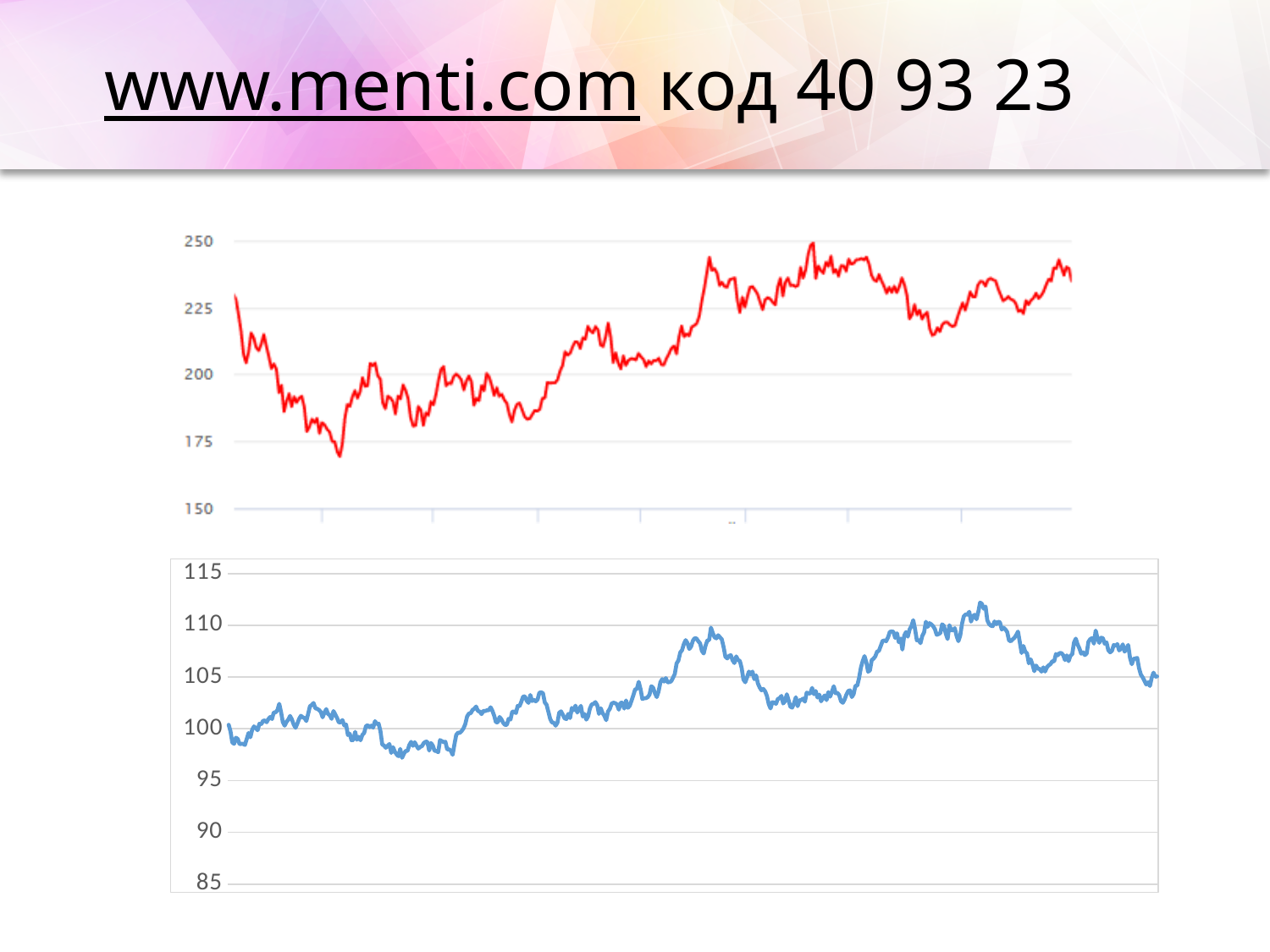
In the top chart, is the highest point of the red line greater or less than 225? greater What kind of chart is the bottom chart on the slide? line chart What kind of chart is the top chart on the slide? line chart In the bottom chart, is the lowest point of the blue line greater or less than 100? less In the top chart, is the value at the right end of the red line greater or less than 225? greater In the bottom chart, does the blue line overall rise or fall from the left end to the right end? rise What is the lowest value shown on the y axis of the bottom chart? 85 In the top chart, does the red line overall rise or fall from its lowest point to the right end? rise What is the highest value shown on the y axis of the top chart? 250